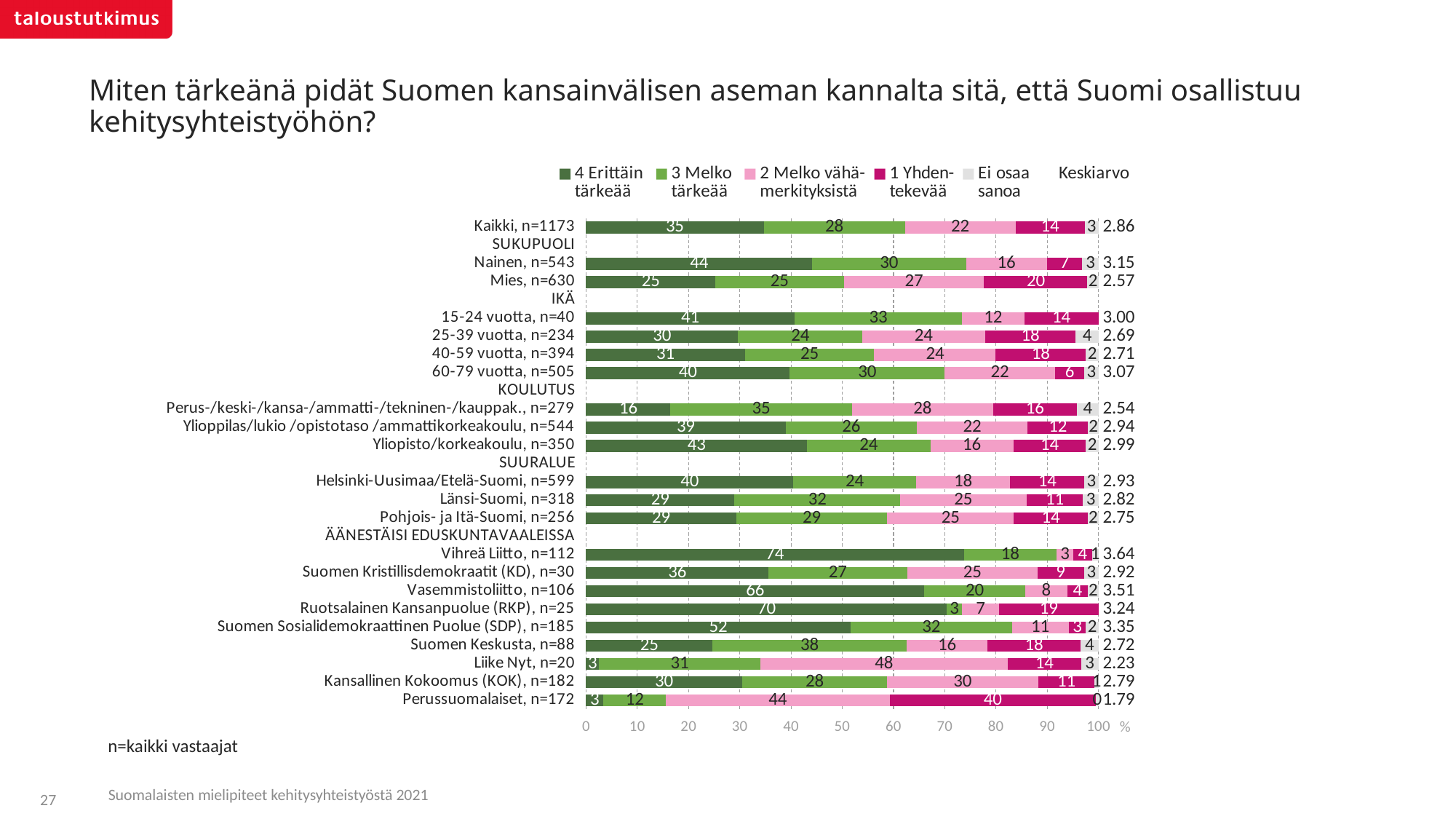
Which group has the highest Keskiarvo value? Vihreä Liitto, n=112 What is the combined percentage of "4 Erittäin tärkeää" and "3 Melko tärkeää" for Vasemmistoliitto, n=106? 86 What does the last column of numbers to the right of the bars represent, according to the legend? Keskiarvo What percentage of all respondents (Kaikki, n=1173) answered "4 Erittäin tärkeää"? 35 What is the Keskiarvo value for Ruotsalainen Kansanpuolue (RKP), n=25? 3.24 What is the "3 Melko tärkeää" percentage for Suomen Keskusta, n=88? 38 Which has a larger "2 Melko vähämerkityksistä" share: Liike Nyt, n=20 or Kansallinen Kokoomus (KOK), n=182? Liike Nyt, n=20 What percentage of Perussuomalaiset, n=172 answered "1 Yhdentekevää"? 40 What is the difference between the "4 Erittäin tärkeää" percentages for Nainen, n=543 and Mies, n=630? 19 Which group has the lowest Keskiarvo value? Perussuomalaiset, n=172 What is the Keskiarvo (mean) value for Nainen, n=543? 3.15 What kind of chart is shown on the slide? Stacked bar chart